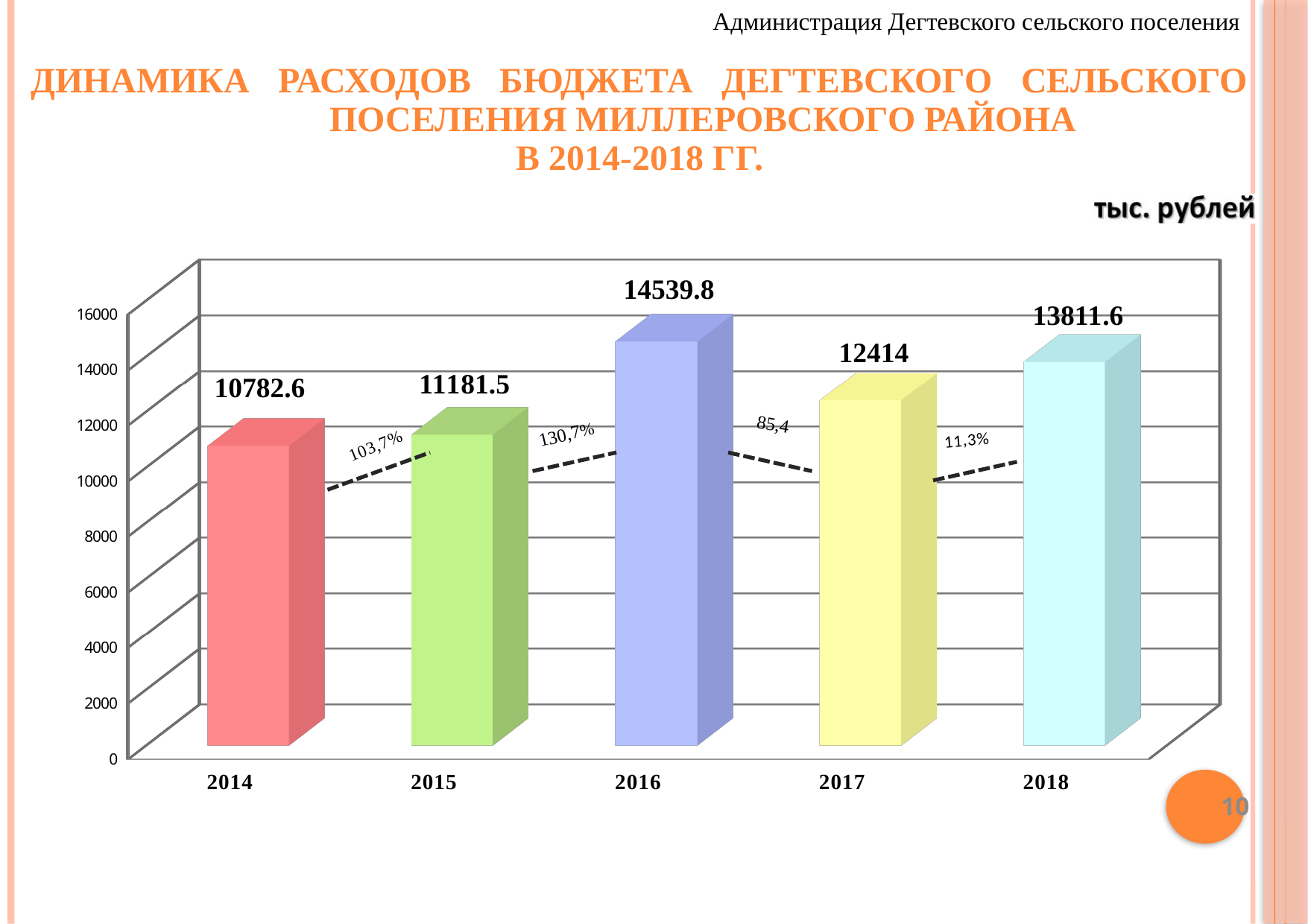
What is the difference between the values for 2016 and 2017? 2125.8 What is the value shown for 2018? 13811.6 What kind of chart is shown on the slide? bar chart Which is larger, the value for 2017 or the value for 2018? 2018 What is the value shown for 2016? 14539.8 What is the budget expenditure value shown for 2014? 10782.6 What unit of measurement is indicated above the chart? тыс. рублей How many years are shown on the x axis of the chart? 5 Which year has the highest value on the chart? 2016 Is the value for 2016 greater or less than 14000? greater What is the difference between the values for 2015 and 2014? 398.9 Which year has the lowest value on the chart? 2014